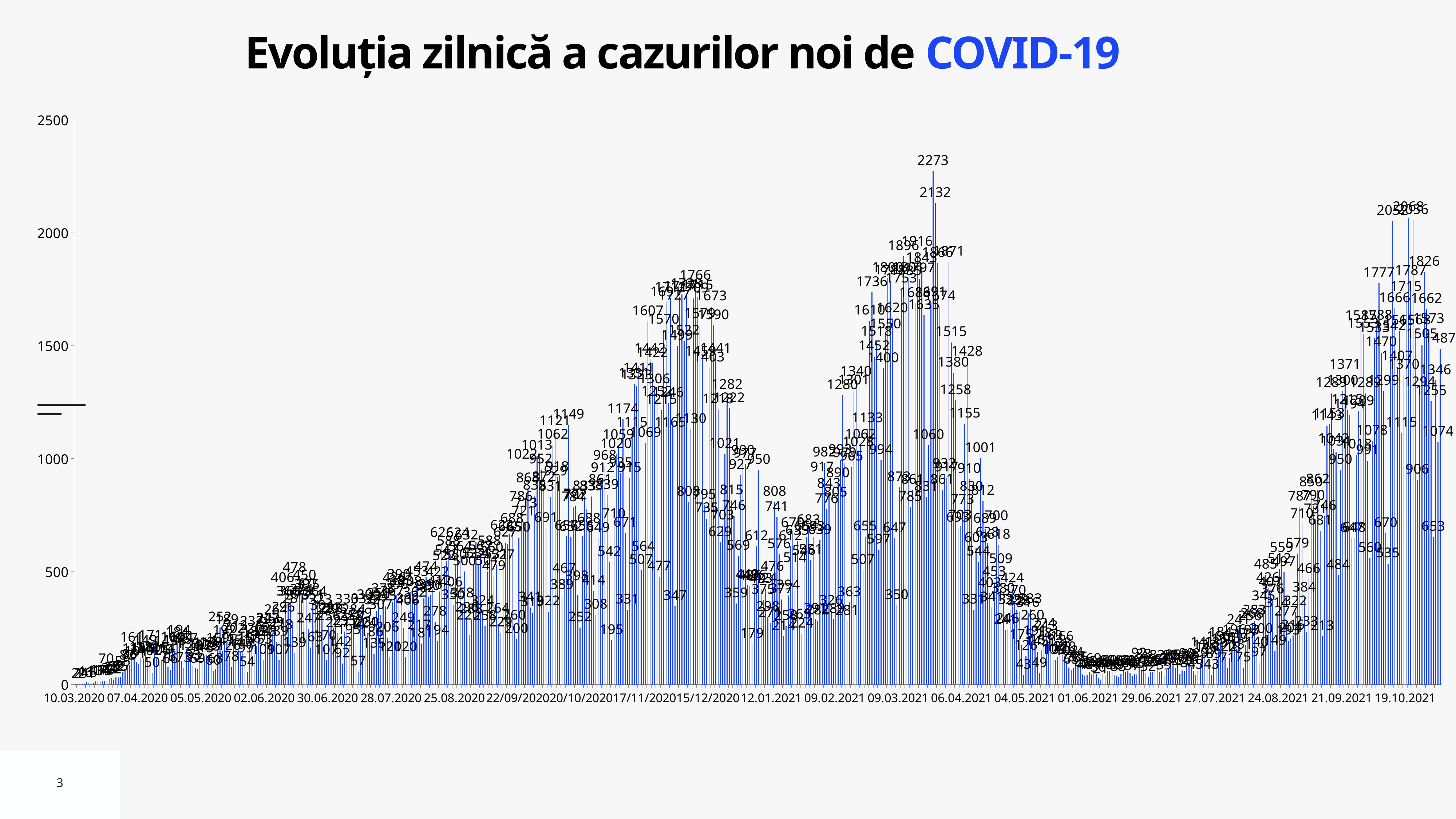
From 01.06.2021 to 19.10.2021, do the daily values generally rise or fall? rise What is the title of the chart? Evoluția zilnică a cazurilor noi de COVID-19 What is the last date label on the horizontal axis? 19.10.2021 What is the difference between the two highest labelled values, 2273 and 2132? 141 What is the highest daily value labelled on the chart? 2273 Is the tallest bar near 06.04.2021 higher or lower than the tallest bar near 15/12/2020? higher What kind of chart is shown on the slide? bar chart Is the highest bar on the chart greater or less than 2000? greater What is the first date label on the horizontal axis? 10.03.2020 Are the daily values around 01.06.2021 greater or less than 500? less What is the second-highest daily value labelled on the chart, just after the 2273 peak? 2132 What is the highest tick value shown on the vertical axis? 2500